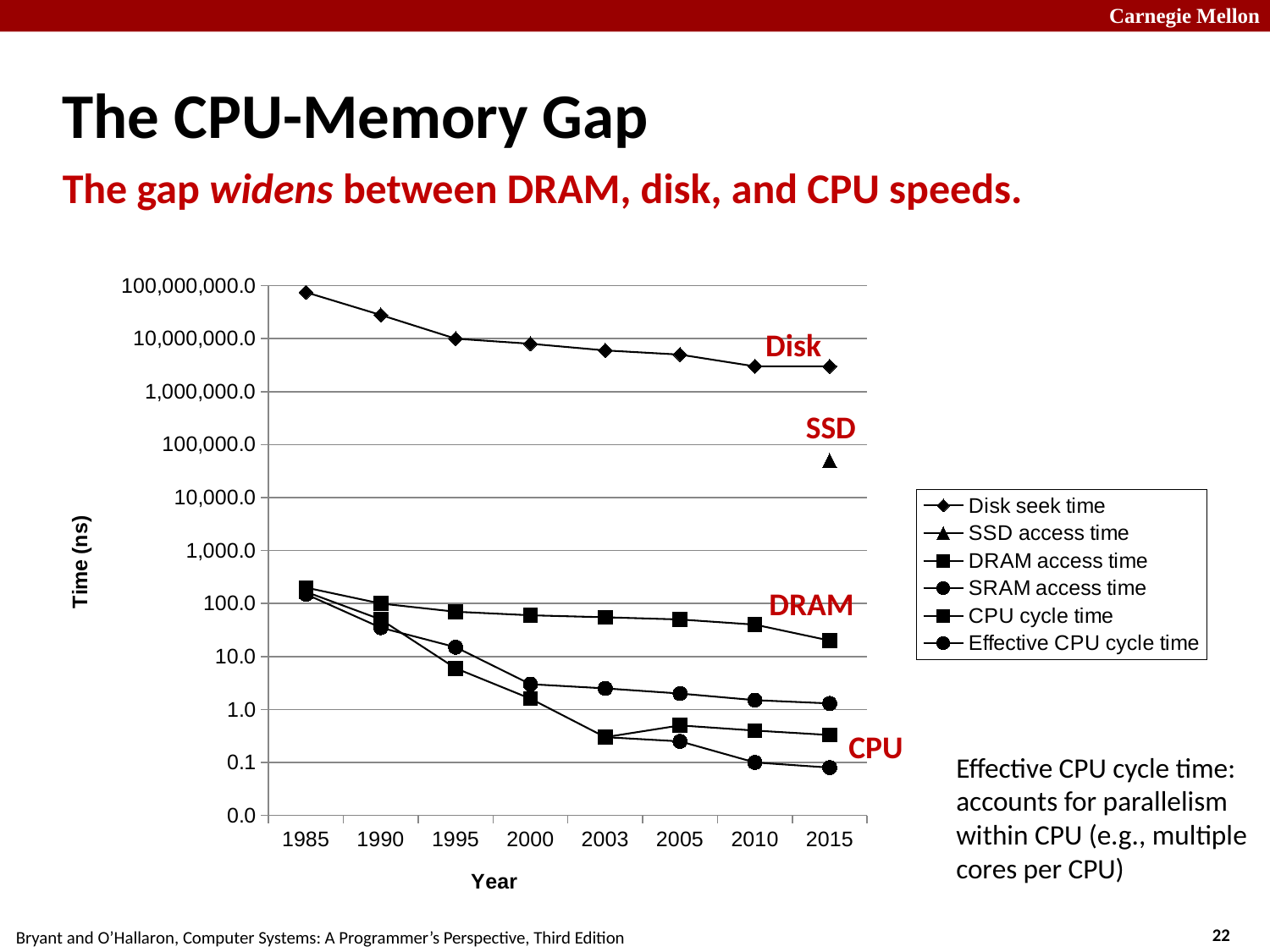
In 2015, which is larger: Disk seek time or DRAM access time? Disk seek time Does the Disk seek time rise or fall from 1985 to 2015? fall Is the SSD access time in 2015 greater or less than 100,000.0? less How many years are plotted along the x axis? 8 What is the title of the y axis? Time (ns) What is the title of the x axis? Year Which series has the lowest value in 2015? Effective CPU cycle time Which series has the highest value in 2015? Disk seek time What kind of chart is shown on the slide? line chart Is the DRAM access time in 2015 greater or less than 100.0? less How many series does the legend list? 6 Is the Disk seek time in 1985 greater or less than 10,000,000.0? greater